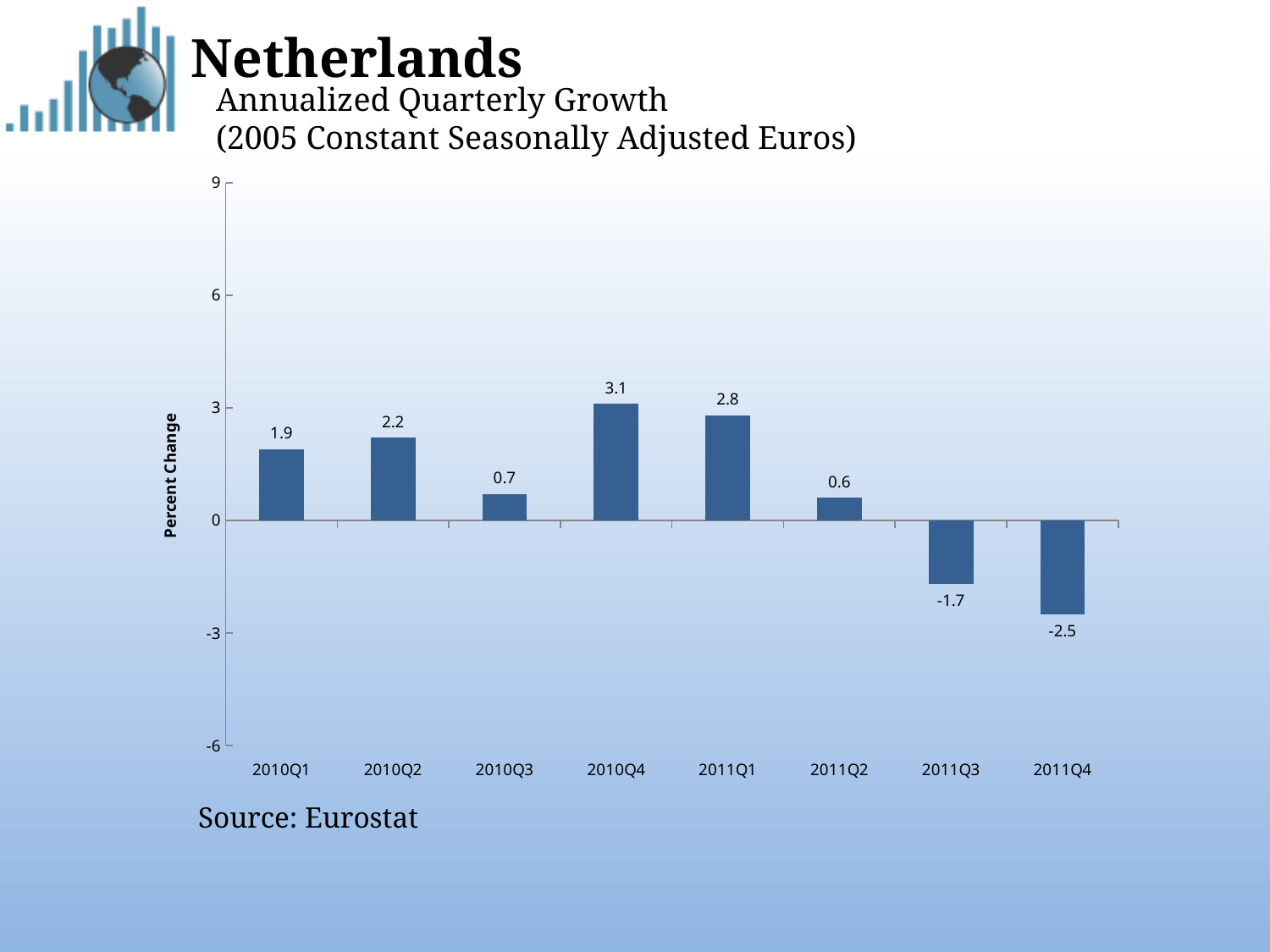
What is the difference between the values for 2010Q2 and 2010Q1? 0.3 Which quarter has the lowest value? 2011Q4 What is the annualized quarterly growth value for 2010Q4? 3.1 Is the value for 2011Q1 greater or less than 3? less Which quarter has the highest value? 2010Q4 How many quarters are shown on the x axis? 8 What is the value shown for 2010Q3? 0.7 What is the value shown for 2011Q3? -1.7 Which is larger, the value for 2010Q2 or the value for 2011Q2? 2010Q2 What is the label on the vertical axis? Percent Change What kind of chart is shown on the slide? bar chart What is the difference between the values for 2010Q4 and 2011Q1? 0.3